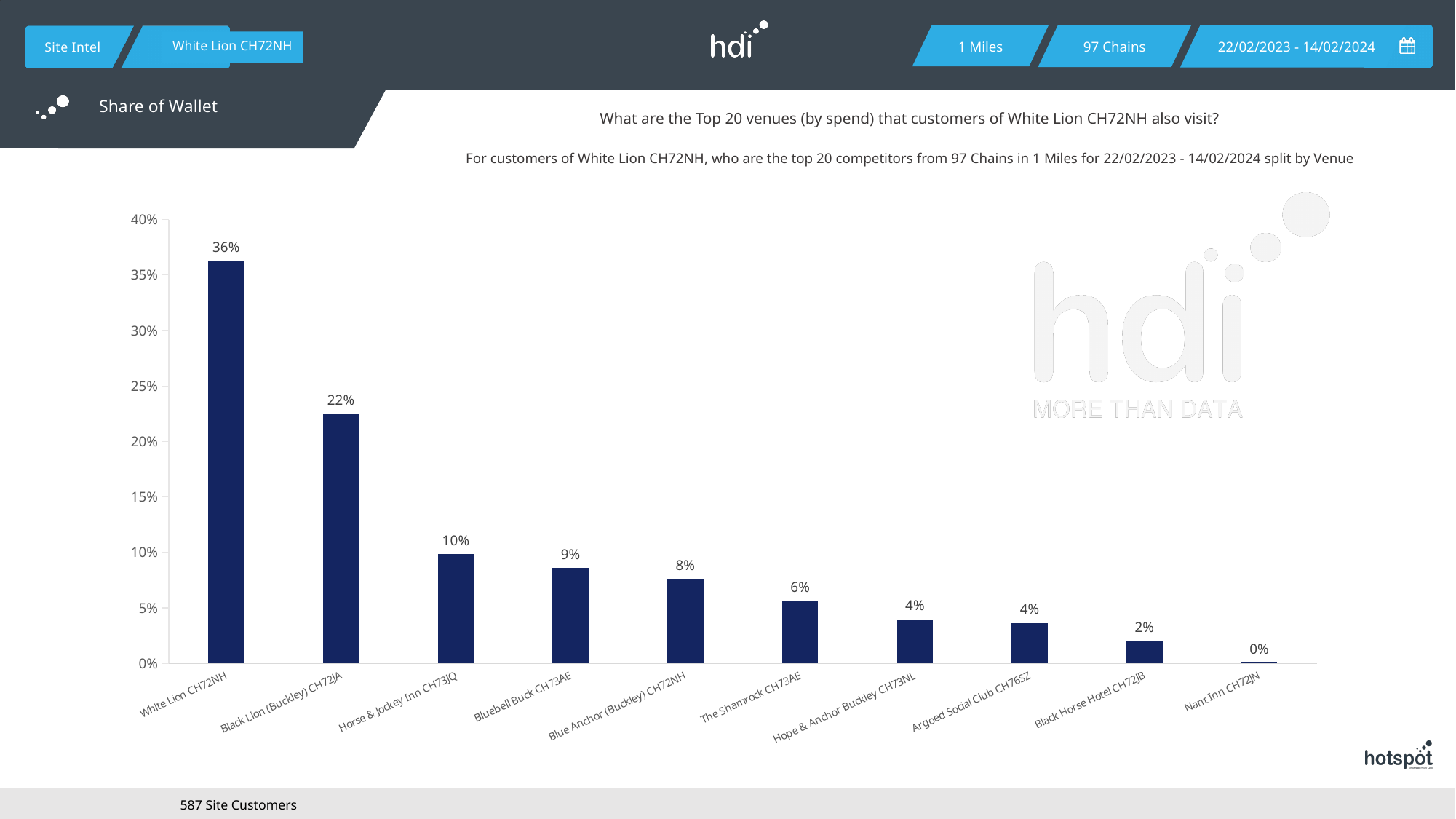
Which venue has the lowest value? Nant Inn CH72JN What kind of chart is shown on the slide? bar chart What is the value for White Lion CH72NH? 36% How many venues are shown on the chart? 10 Which venue has the highest value? White Lion CH72NH What is the value for Horse & Jockey Inn CH73JQ? 10% Do the values rise or fall from left to right along the x axis? fall What is the value for Black Lion (Buckley) CH72JA? 22% What is the difference between the values for White Lion CH72NH and Black Lion (Buckley) CH72JA? 14% Is the value for Blue Anchor (Buckley) CH72NH greater or less than 10%? less Which is larger, the value for Bluebell Buck CH73AE or the value for The Shamrock CH73AE? Bluebell Buck CH73AE What is the value for Black Horse Hotel CH72JB? 2%